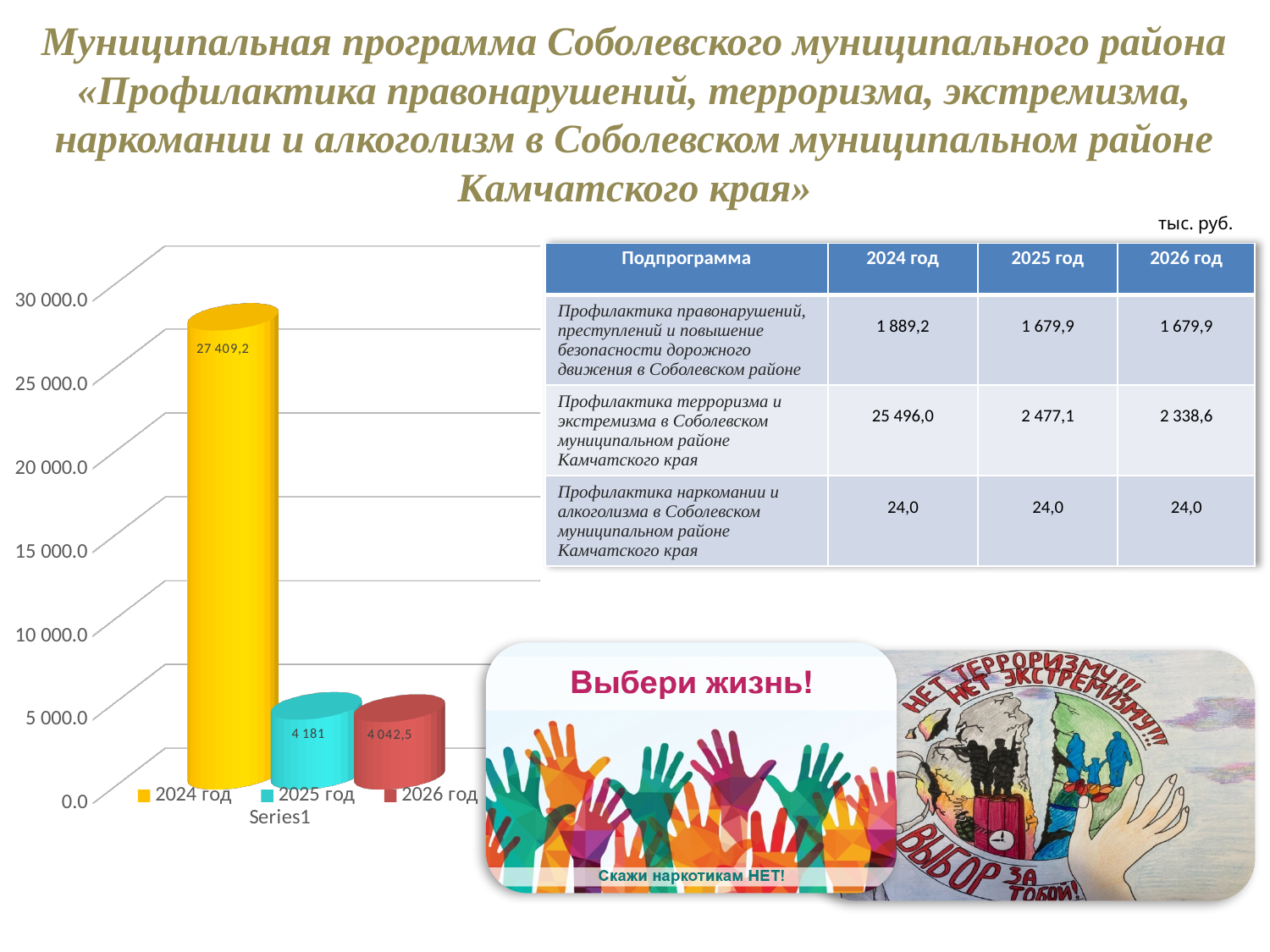
What kind of chart is shown on the slide? bar chart Which series has the highest value in the bar chart? 2024 год Which is larger in the bar chart, the value for 2025 год or the value for 2026 год? 2025 год Is the value for 2024 год in the bar chart greater or less than 25 000.0? greater What is the value for 2024 год in the bar chart? 27 409,2 How many series does the legend of the bar chart list? 3 What is the difference between the values for 2024 год and 2025 год in the bar chart? 23 228,2 Which series has the lowest value in the bar chart? 2026 год What is the value for 2026 год in the bar chart? 4 042,5 What is the difference between the values for 2025 год and 2026 год in the bar chart? 138,5 Is the value for 2025 год in the bar chart greater or less than 5 000.0? less What is the value for 2025 год in the bar chart? 4 181